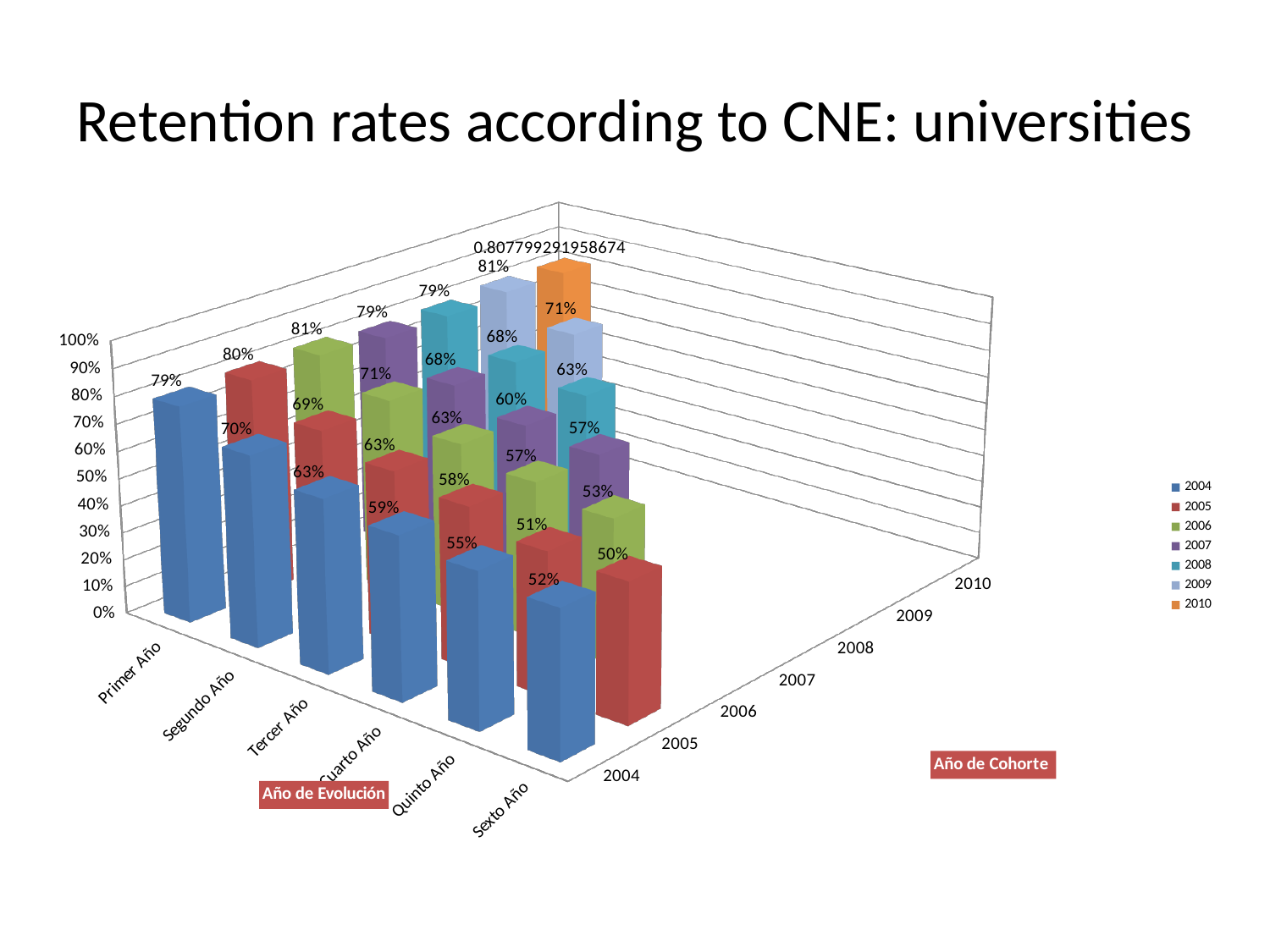
What is the title of the chart? Retention rates according to CNE: universities What is the retention rate for the 2004 cohort in Sexto Año? 52% For the 2004 cohort, do retention rates rise or fall from Primer Año to Sexto Año? fall How many categories are shown along the 'Año de Evolución' axis? 6 How many series does the legend list? 7 Which is larger for Segundo Año: the 2004 cohort value or the 2005 cohort value? 2004 cohort (70%) What is the retention rate for the 2005 cohort in Sexto Año? 50% What is the retention rate for the 2004 cohort in Tercer Año? 63% What is the retention rate for the 2004 cohort in Primer Año? 79% For the 2004 cohort, what is the difference between the Primer Año and Sexto Año retention rates? 27% For the 2004 cohort, which year of evolution has the lowest retention rate? Sexto Año What kind of chart is shown on the slide? bar chart